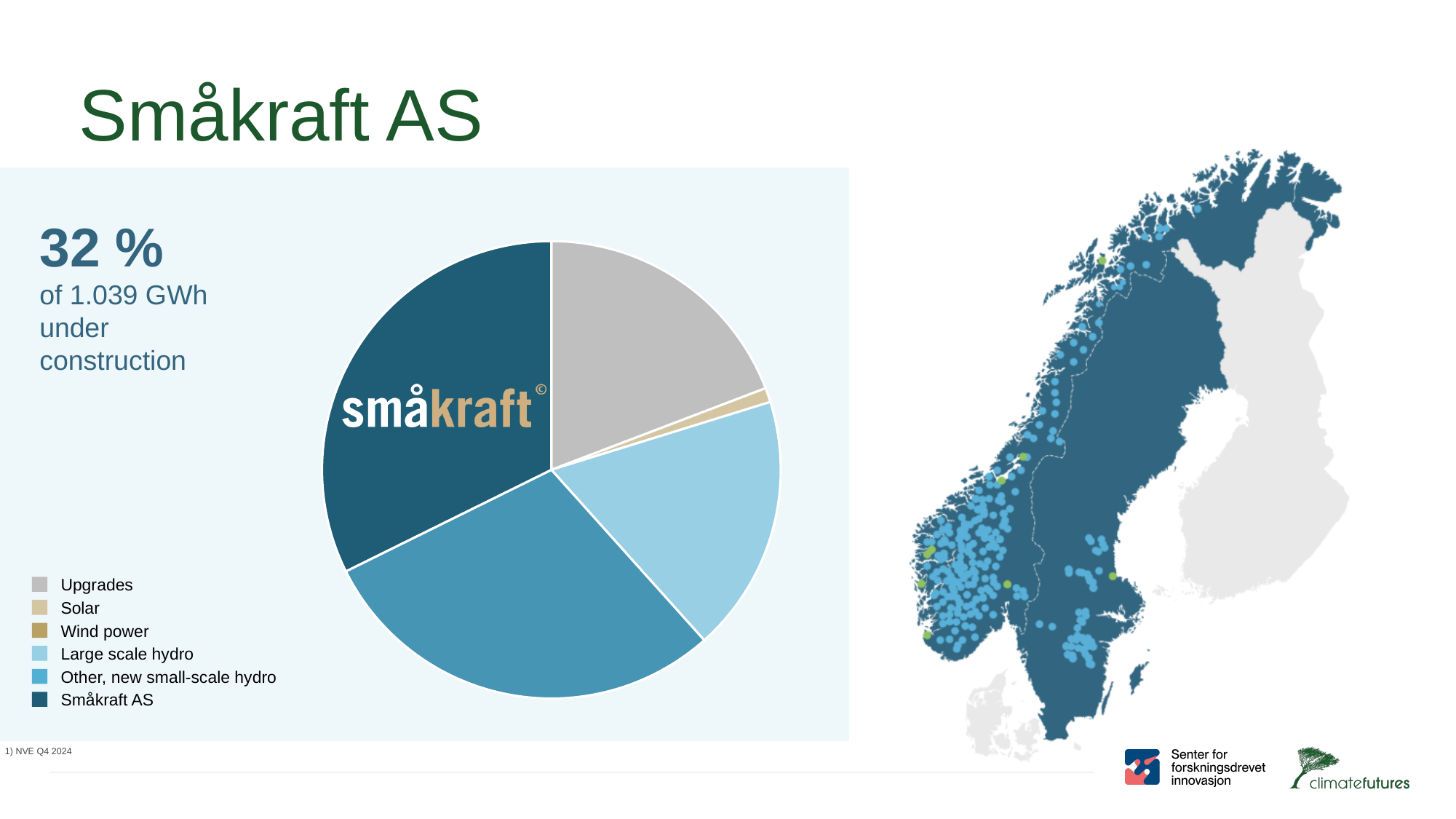
Which is larger in the pie chart, the Småkraft AS slice or the Upgrades slice? Småkraft AS Which is larger in the pie chart, the Upgrades slice or the Solar slice? Upgrades What source is cited in the footnote of the slide? NVE Q4 2024 What colour is the Upgrades slice in the pie chart? grey Is the share for Småkraft AS in the pie chart greater or less than 25%? greater What kind of chart is shown on the slide? pie chart What share of the pie chart does Småkraft AS account for? 32 % Which is larger in the pie chart, the Large scale hydro slice or the Solar slice? Large scale hydro What total amount under construction does the pie chart represent? 1.039 GWh How many categories does the pie chart's legend list? 6